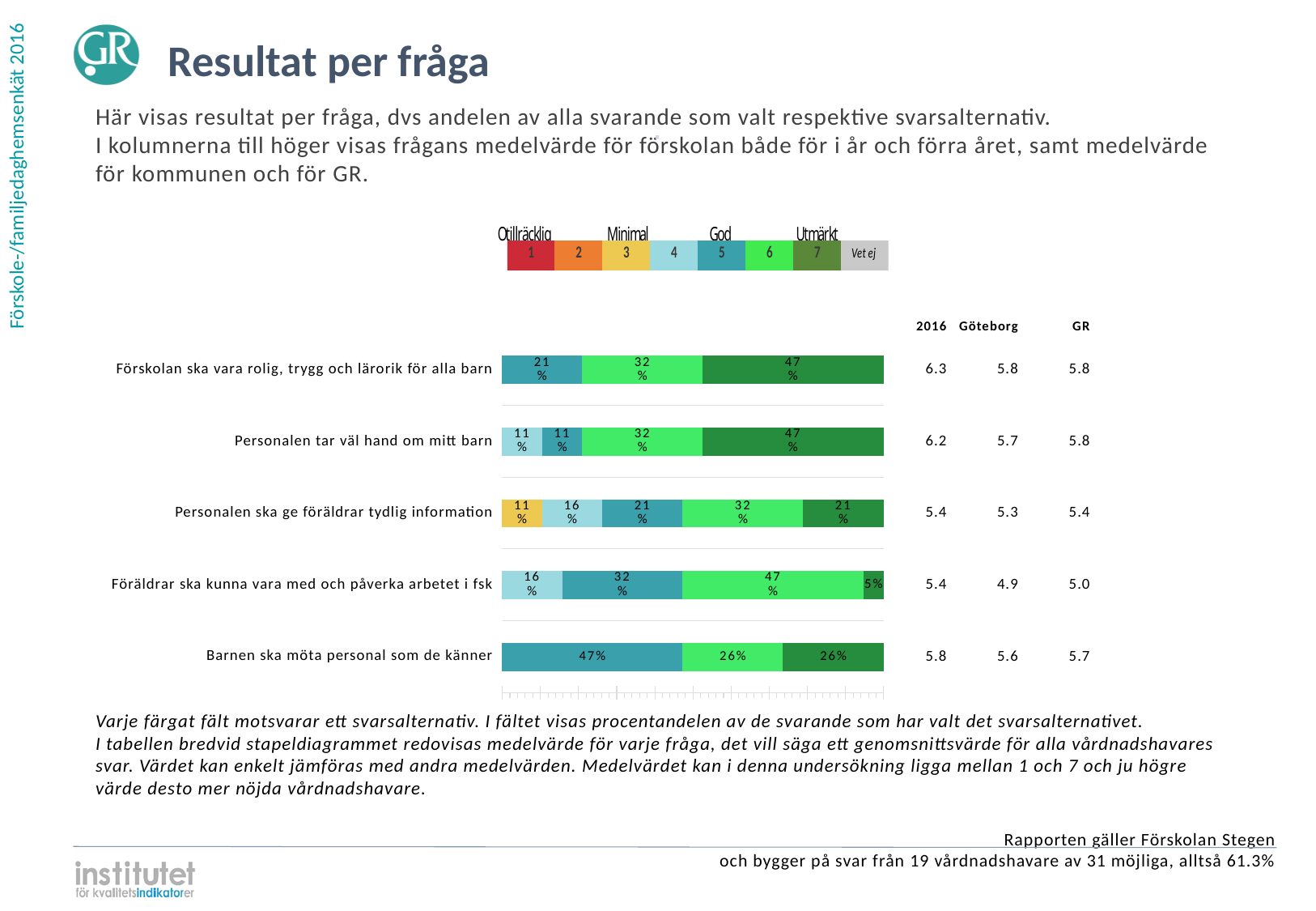
What is the difference between the 47% and 21% segments in the bar "Förskolan ska vara rolig, trygg och lärorik för alla barn"? 26% How many answer alternatives, including "Vet ej", does the colour legend above the chart show? 8 What percentage of respondents chose answer 3 (yellow) for "Personalen ska ge föräldrar tydlig information"? 11% What is the Göteborg mean value shown for "Föräldrar ska kunna vara med och påverka arbetet i fsk"? 4.9 What is the smallest segment value shown in the bar for "Föräldrar ska kunna vara med och påverka arbetet i fsk"? 5% How many questions (categories) are plotted in the bar chart? 5 What kind of chart is shown on the slide? Stacked bar chart Which question has the highest 2016 mean value in the table next to the chart? Förskolan ska vara rolig, trygg och lärorik för alla barn What percentage is shown for the largest segment of the bar "Barnen ska möta personal som de känner"? 47% What is the 2016 mean value shown for "Förskolan ska vara rolig, trygg och lärorik för alla barn"? 6.3 Which is larger in the bar "Personalen ska ge föräldrar tydlig information": the segment for answer 6 (light green) or the segment for answer 7 (dark green)? Answer 6 (32%) What percentage of respondents chose answer 7 (dark green) for "Förskolan ska vara rolig, trygg och lärorik för alla barn"? 47%